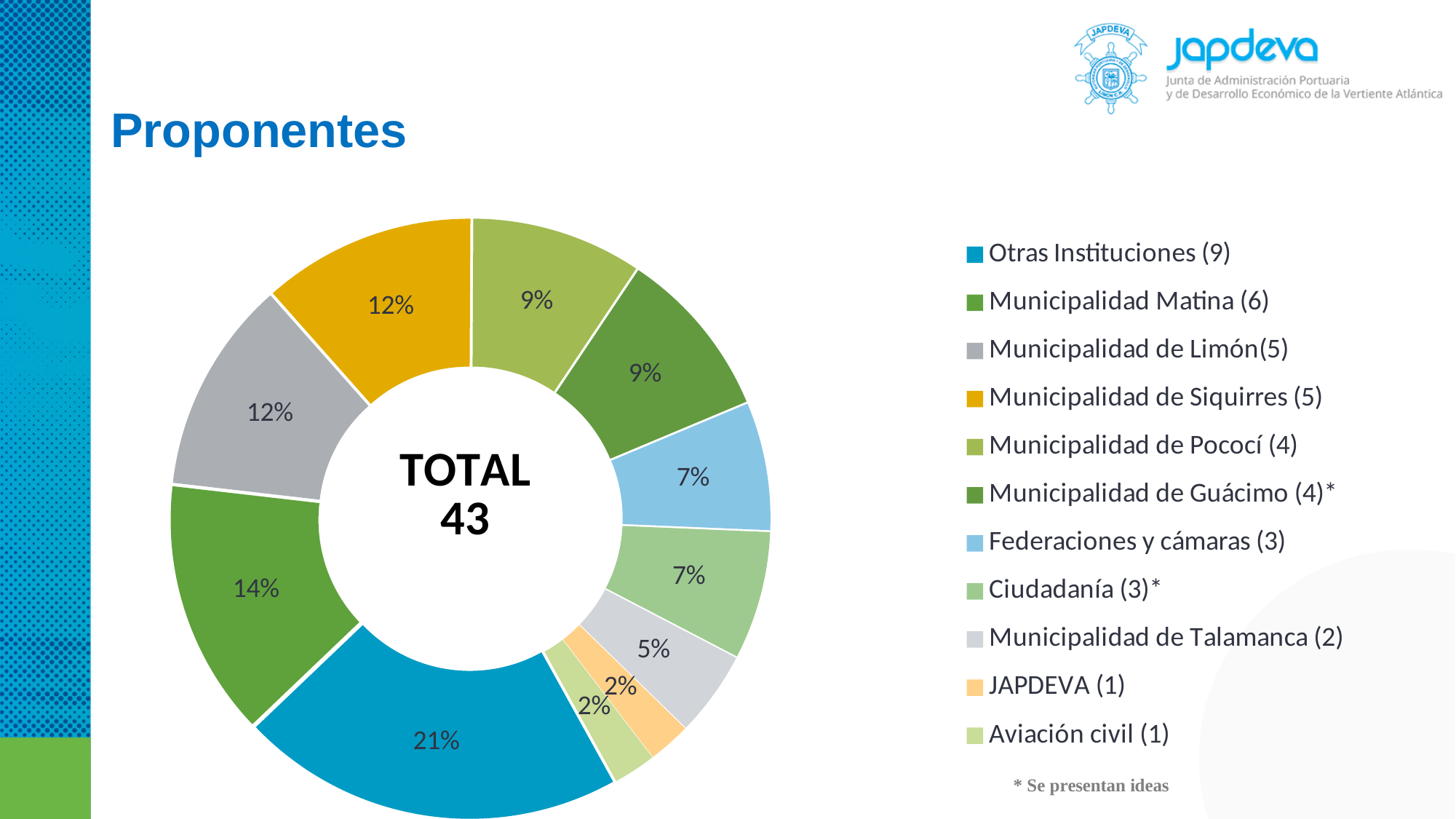
What total is shown in the centre of the chart? 43 How many proponents does the legend list for Municipalidad de Siquirres? 5 What percentage of the pie chart does Otras Instituciones represent? 21% How many proponents does the legend list for JAPDEVA? 1 What percentage share is shown for Municipalidad de Talamanca? 5% Which category has the largest share of the pie chart? Otras Instituciones What percentage share is shown for Federaciones y cámaras? 7% What is the difference in percentage points between the shares of Otras Instituciones and Municipalidad Matina? 7 percentage points How many categories are shown in the pie chart? 11 What type of chart is shown on the slide? Pie chart (donut) Which has a larger share, Municipalidad de Limón or Municipalidad de Pococí? Municipalidad de Limón